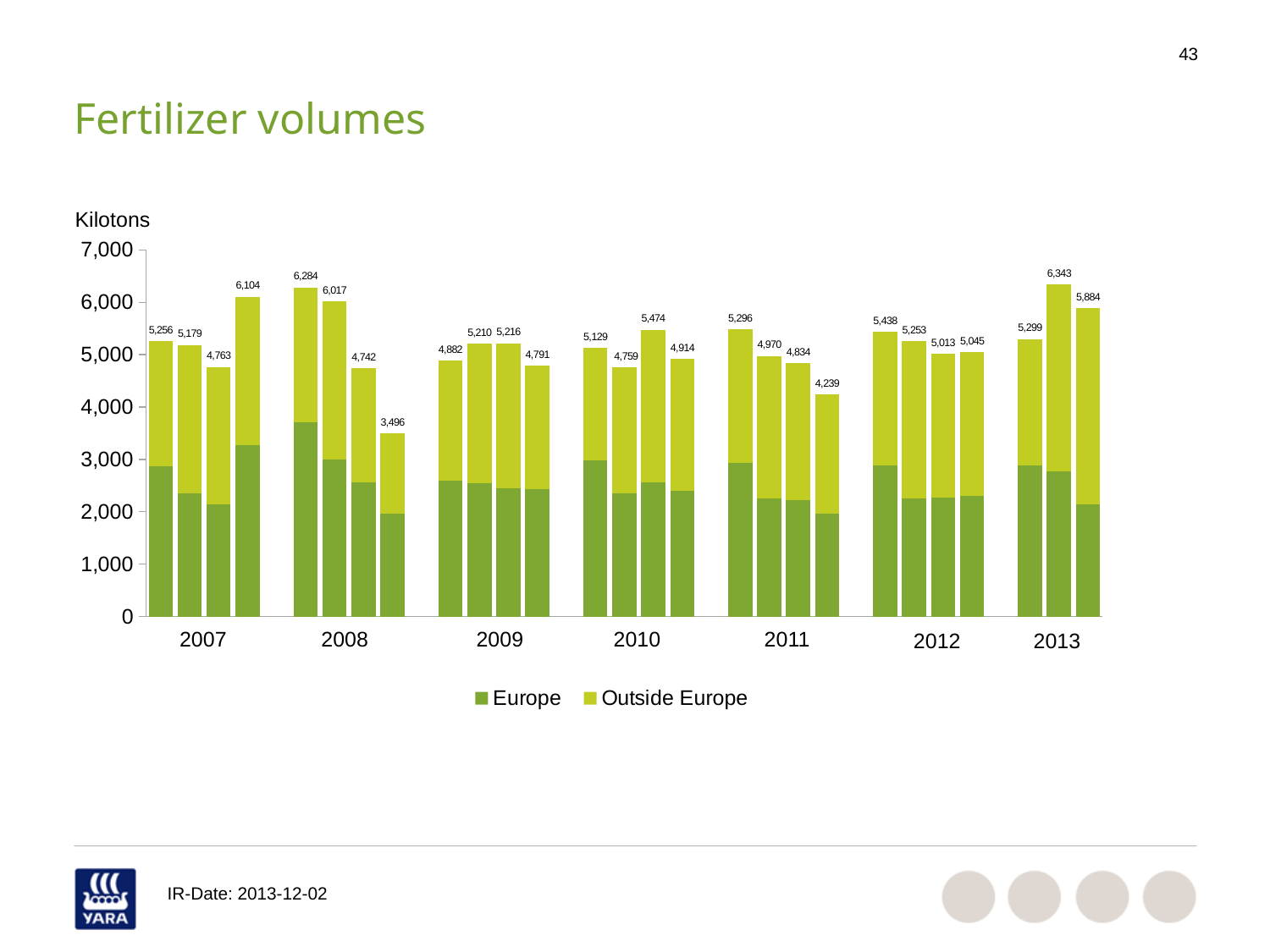
Which is larger: the first bar of 2011 or the first bar of 2012? The first bar of 2012 (5,438) What is the difference between the first bar of 2008 (6,284) and the second bar of 2008 (6,017)? 267 What type of chart is shown on the slide? Stacked bar chart What is the total value labelled on the first bar of 2007? 5,256 What is the total value labelled on the third bar of 2010? 5,474 How many series does the legend list? 2 What unit is shown on the y axis of the chart? Kilotons What is the total value labelled on the last bar of 2008? 3,496 How many bars are shown for 2013? 3 Which bar has the highest labelled total in the chart? The second bar of 2013 (6,343) Which bar has the lowest labelled total in the chart? The fourth bar of 2008 (3,496) Is the Europe segment of the first bar of 2008 greater or less than 3,000? greater